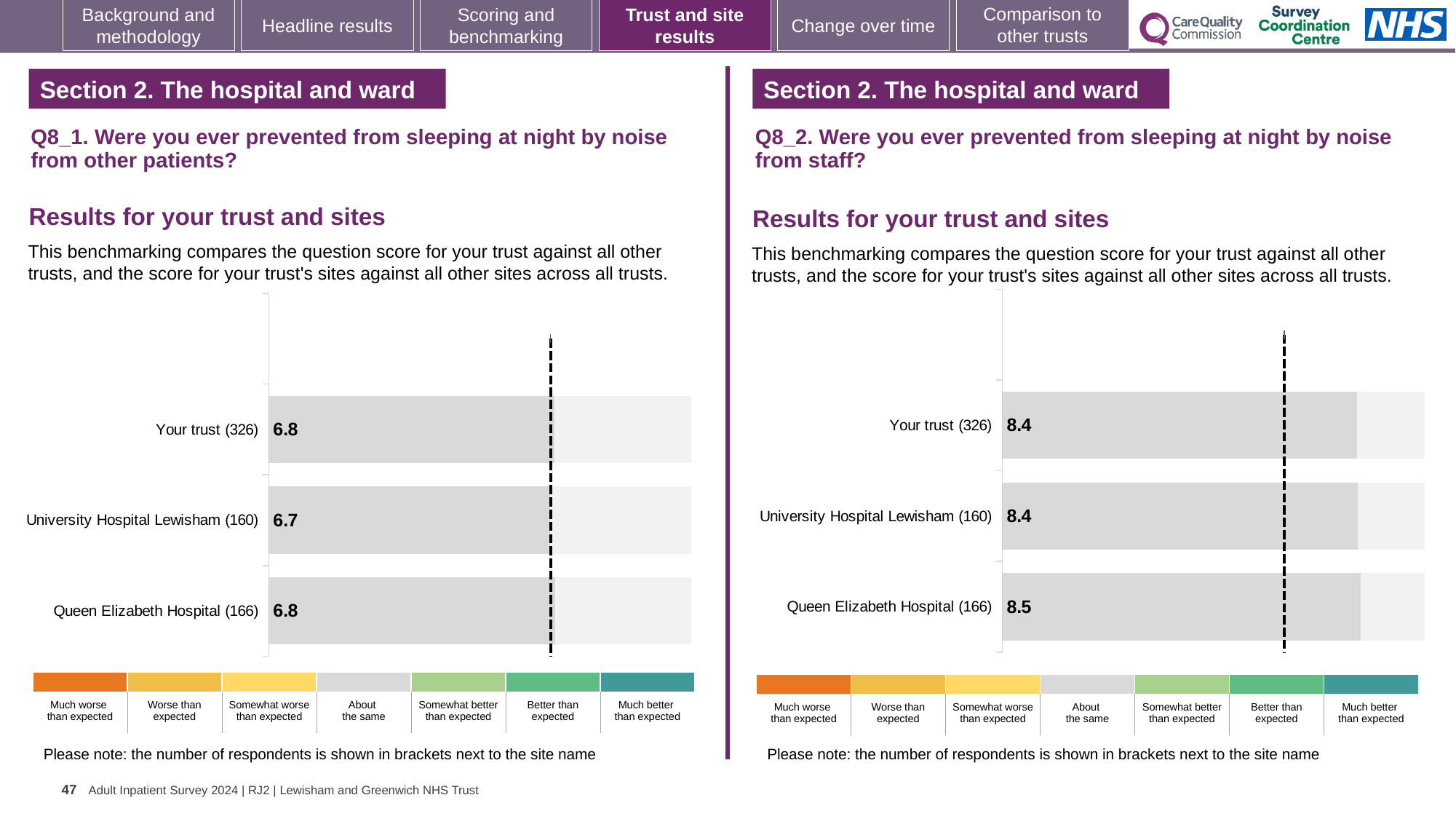
In the Q8_2 chart (noise from staff), what is the difference between the scores for Queen Elizabeth Hospital (166) and University Hospital Lewisham (160)? 0.1 In the Q8_2 chart (noise from staff), what is the score for Your trust (326)? 8.4 How many bars are plotted in the Q8_1 chart (noise from other patients)? 3 In the Q8_2 chart (noise from staff), which site has the highest score? Queen Elizabeth Hospital (166) In the Q8_2 chart (noise from staff), what is the score for Queen Elizabeth Hospital (166)? 8.5 What type of chart is used for the Q8_2 results (noise from staff)? Bar chart In the Q8_1 chart (noise from other patients), what is the difference between the scores for Your trust (326) and University Hospital Lewisham (160)? 0.1 In the Q8_1 chart (noise from other patients), what is the score for University Hospital Lewisham (160)? 6.7 In the Q8_2 chart (noise from staff), how many respondents are shown in brackets for Your trust? 326 In the Q8_1 chart (noise from other patients), what is the score for Your trust (326)? 6.8 In the Q8_1 chart (noise from other patients), what is the score for Queen Elizabeth Hospital (166)? 6.8 In the Q8_1 chart (noise from other patients), which site has the lowest score? University Hospital Lewisham (160)